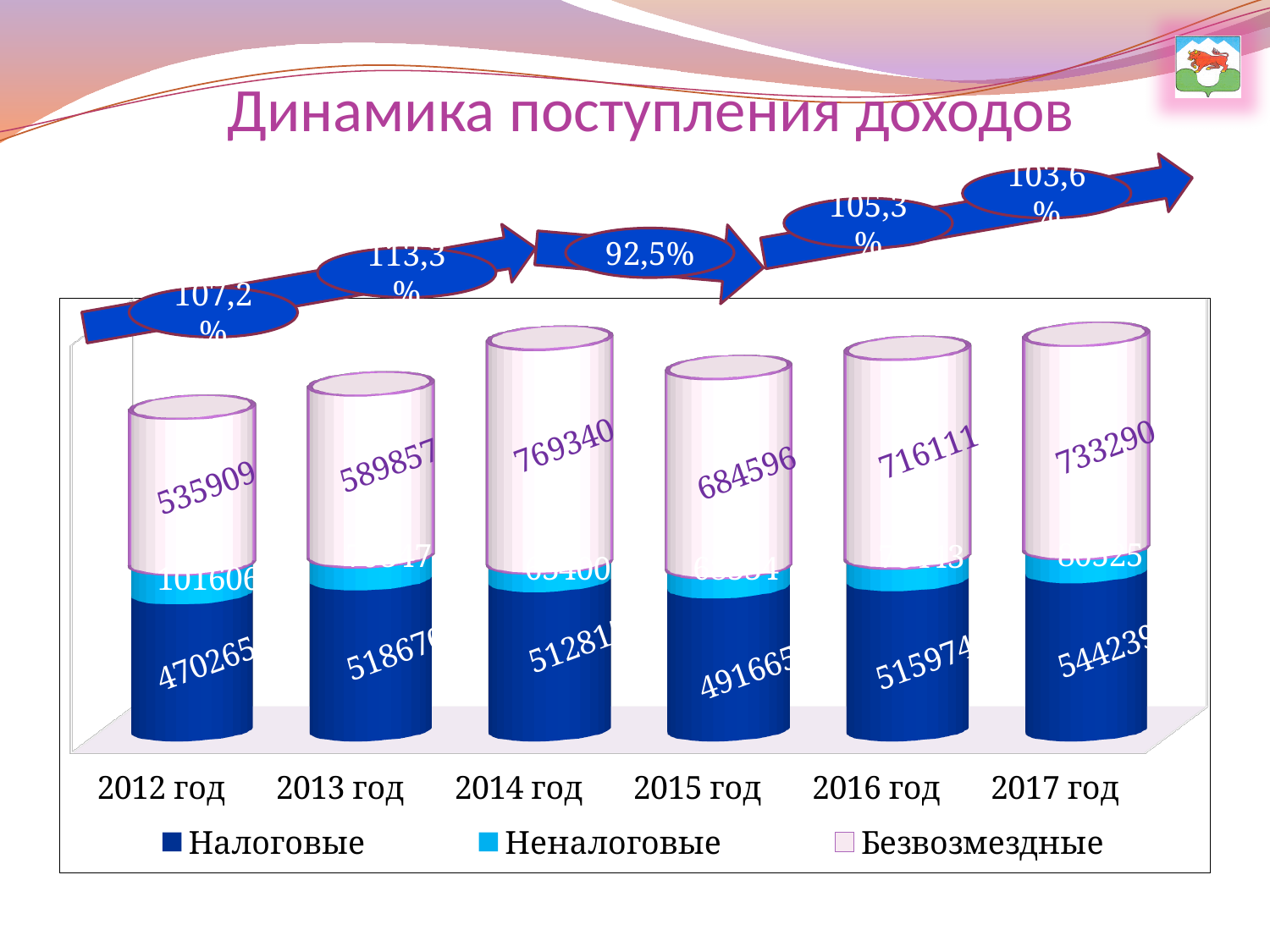
How many series does the chart legend list? 3 In which year is the Безвозмездные value the highest? 2014 год What is the difference between the Безвозмездные values for 2017 год and 2016 год? 17179 What is the value of Безвозмездные for 2014 год? 769340 In which year is the Безвозмездные value the lowest? 2012 год What is the value of Неналоговые for 2012 год? 101606 What is the value of Налоговые for 2012 год? 470265 Which year has the larger Налоговые value, 2015 год or 2016 год? 2016 год What is the value of Налоговые for 2017 год? 544239 What is the value of Безвозмездные for 2012 год? 535909 What kind of chart is shown on the slide? bar chart How many years (categories) are shown on the x axis of the chart? 6